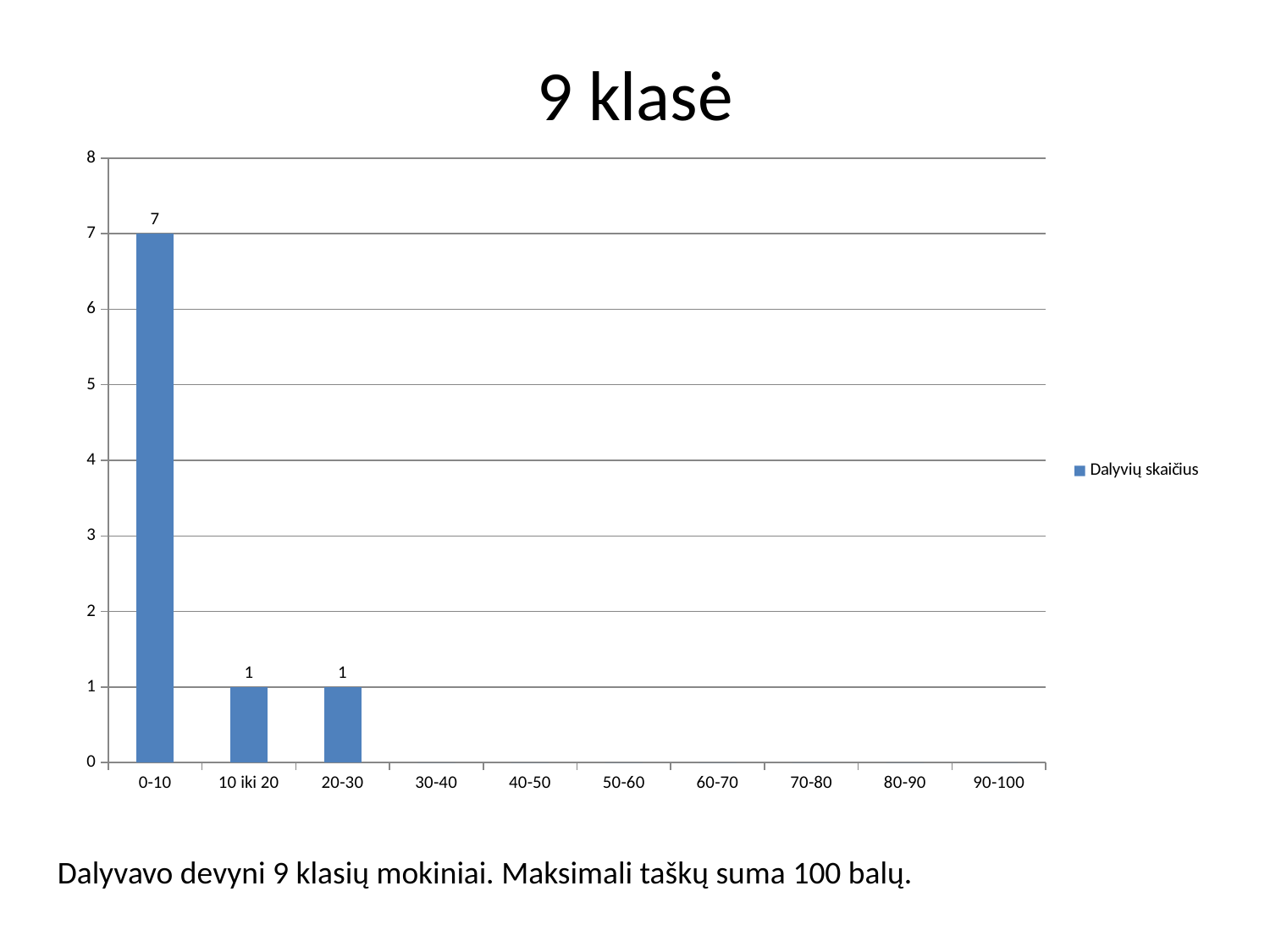
How many categories are shown on the x axis? 10 Is the value for 0-10 greater or less than 5? greater Which is larger, the value for 0-10 or the value for 10 iki 20? 0-10 What is the value for the 10 iki 20 category? 1 How many series does the legend list? 1 What kind of chart is shown on the slide? bar chart What is the difference between the values for 0-10 and 20-30? 6 What is the title of the slide? 9 klasė What is the value for the 20-30 category? 1 What is the name of the series in the legend? Dalyvių skaičius Which category has the highest value? 0-10 What is the value for the 0-10 category? 7